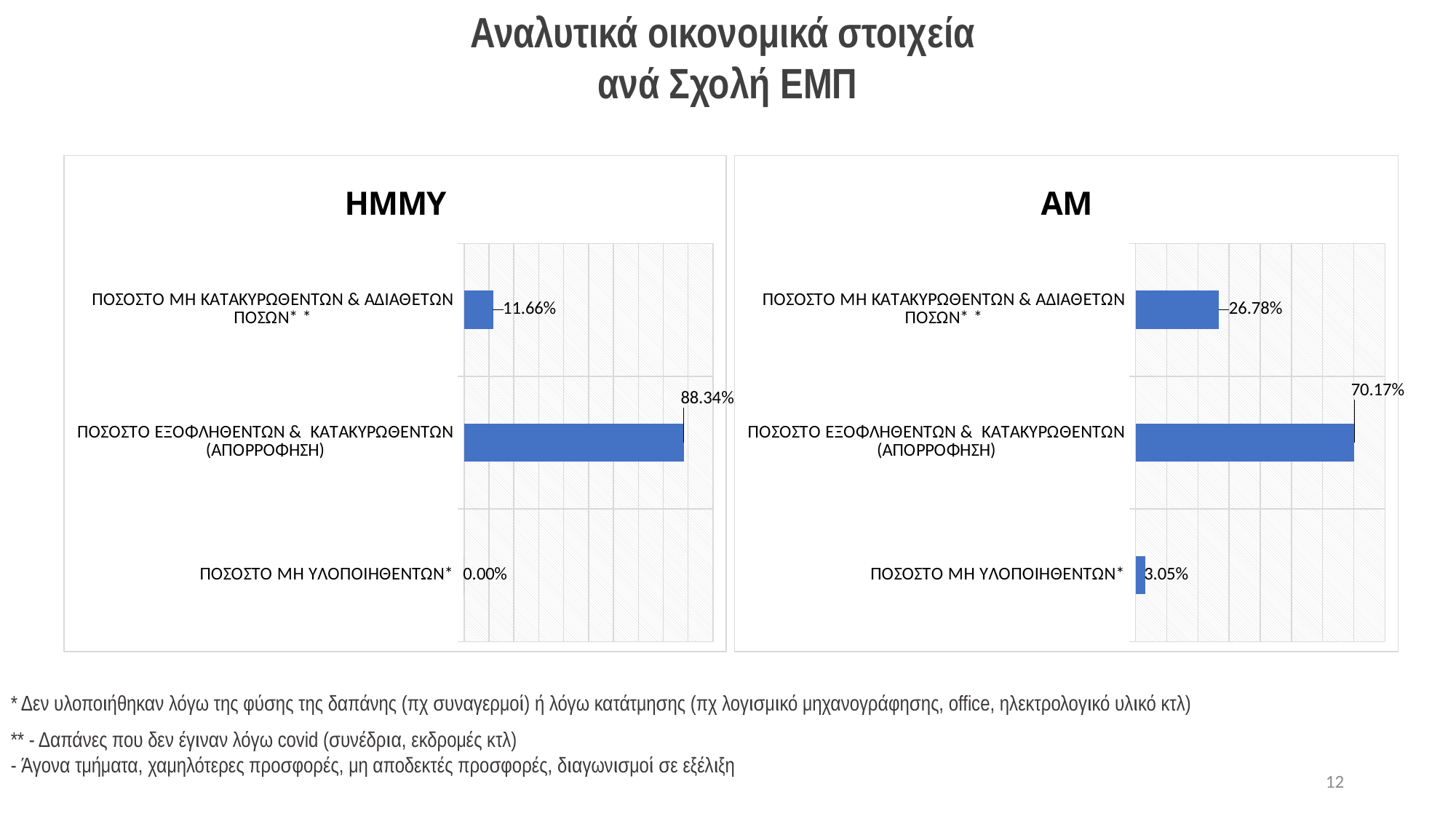
In the ΑΜ chart, what is the value for ΠΟΣΟΣΤΟ ΜΗ ΚΑΤΑΚΥΡΩΘΕΝΤΩΝ & ΑΔΙΑΘΕΤΩΝ ΠΟΣΩΝ? 26.78% In the ΑΜ chart, what is the value for ΠΟΣΟΣΤΟ ΕΞΟΦΛΗΘΕΝΤΩΝ & ΚΑΤΑΚΥΡΩΘΕΝΤΩΝ (ΑΠΟΡΡΟΦΗΣΗ)? 70.17% In the ΗΜΜΥ chart, what is the value for ΠΟΣΟΣΤΟ ΕΞΟΦΛΗΘΕΝΤΩΝ & ΚΑΤΑΚΥΡΩΘΕΝΤΩΝ (ΑΠΟΡΡΟΦΗΣΗ)? 88.34% In the ΗΜΜΥ chart, which category has the lowest value? ΠΟΣΟΣΤΟ ΜΗ ΥΛΟΠΟΙΗΘΕΝΤΩΝ Which chart shows a larger value for ΠΟΣΟΣΤΟ ΜΗ ΚΑΤΑΚΥΡΩΘΕΝΤΩΝ & ΑΔΙΑΘΕΤΩΝ ΠΟΣΩΝ, ΗΜΜΥ or ΑΜ? ΑΜ In the ΑΜ chart, which category has the highest value? ΠΟΣΟΣΤΟ ΕΞΟΦΛΗΘΕΝΤΩΝ & ΚΑΤΑΚΥΡΩΘΕΝΤΩΝ (ΑΠΟΡΡΟΦΗΣΗ) What type of chart is the ΗΜΜΥ chart? Bar chart In the ΗΜΜΥ chart, what is the value for ΠΟΣΟΣΤΟ ΜΗ ΚΑΤΑΚΥΡΩΘΕΝΤΩΝ & ΑΔΙΑΘΕΤΩΝ ΠΟΣΩΝ? 11.66% What is the difference between the ΑΠΟΡΡΟΦΗΣΗ value in the ΗΜΜΥ chart and the ΑΠΟΡΡΟΦΗΣΗ value in the ΑΜ chart? 18.17% How many categories are shown in the ΑΜ chart? 3 In the ΑΜ chart, what is the value for ΠΟΣΟΣΤΟ ΜΗ ΥΛΟΠΟΙΗΘΕΝΤΩΝ? 3.05% In the ΗΜΜΥ chart, what is the value for ΠΟΣΟΣΤΟ ΜΗ ΥΛΟΠΟΙΗΘΕΝΤΩΝ? 0.00%